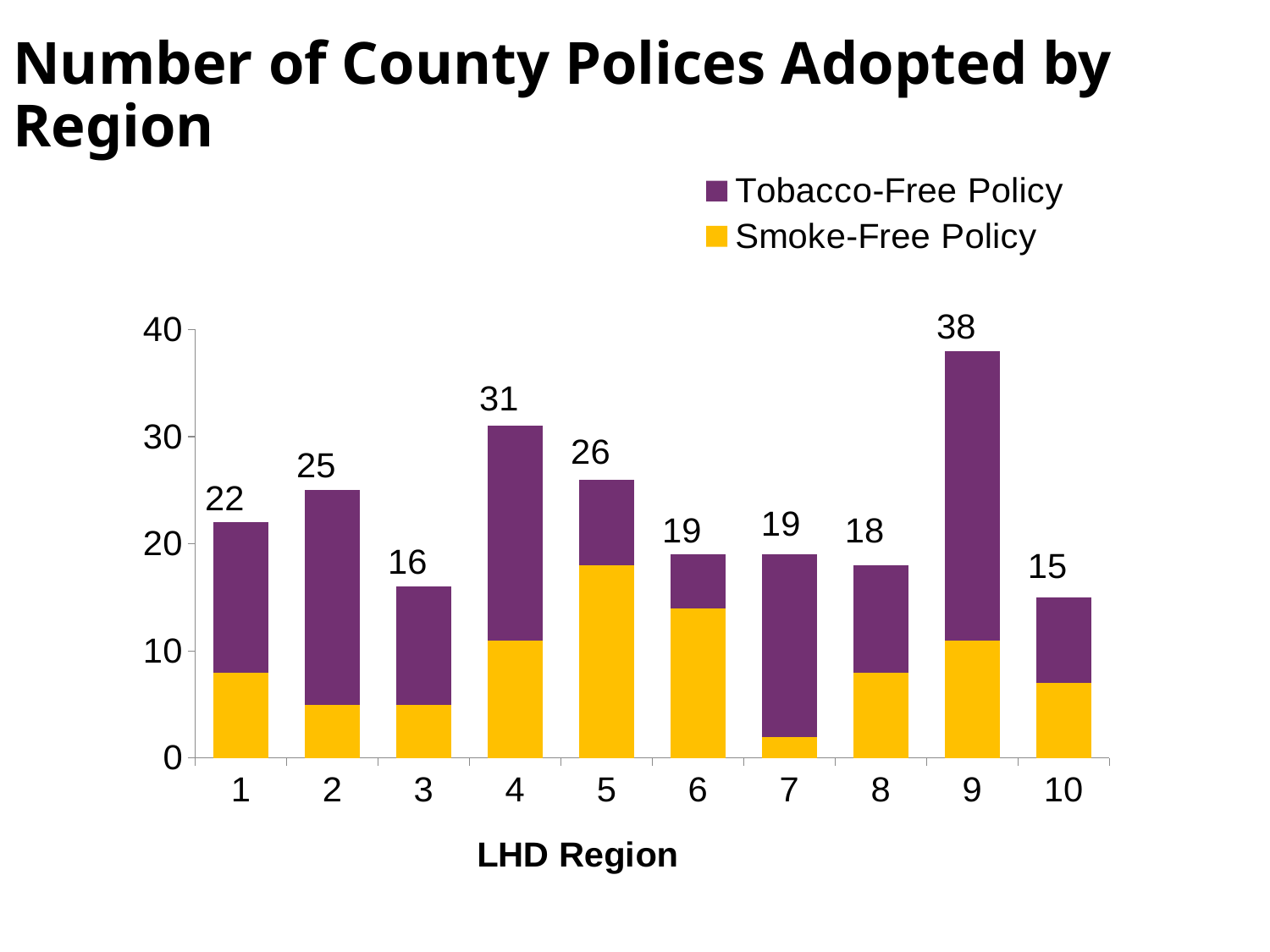
Which colour represents the Tobacco-Free Policy series? Purple Which LHD Region has the highest total number of policies adopted? 9 How many series does the legend list? 2 What is the difference between the total policies in Region 9 and Region 10? 23 Is the Smoke-Free Policy value for Region 5 greater or less than 10? greater Which has a larger total of policies adopted, Region 2 or Region 5? Region 5 Which LHD Region has the lowest total number of policies adopted? 10 What is the total number of county policies adopted in LHD Region 9? 38 Is the Smoke-Free Policy value for Region 7 greater or less than 10? less How many LHD Regions are shown on the x axis? 10 What is the total number of county policies adopted in LHD Region 4? 31 What kind of chart is shown on the slide? Stacked bar chart